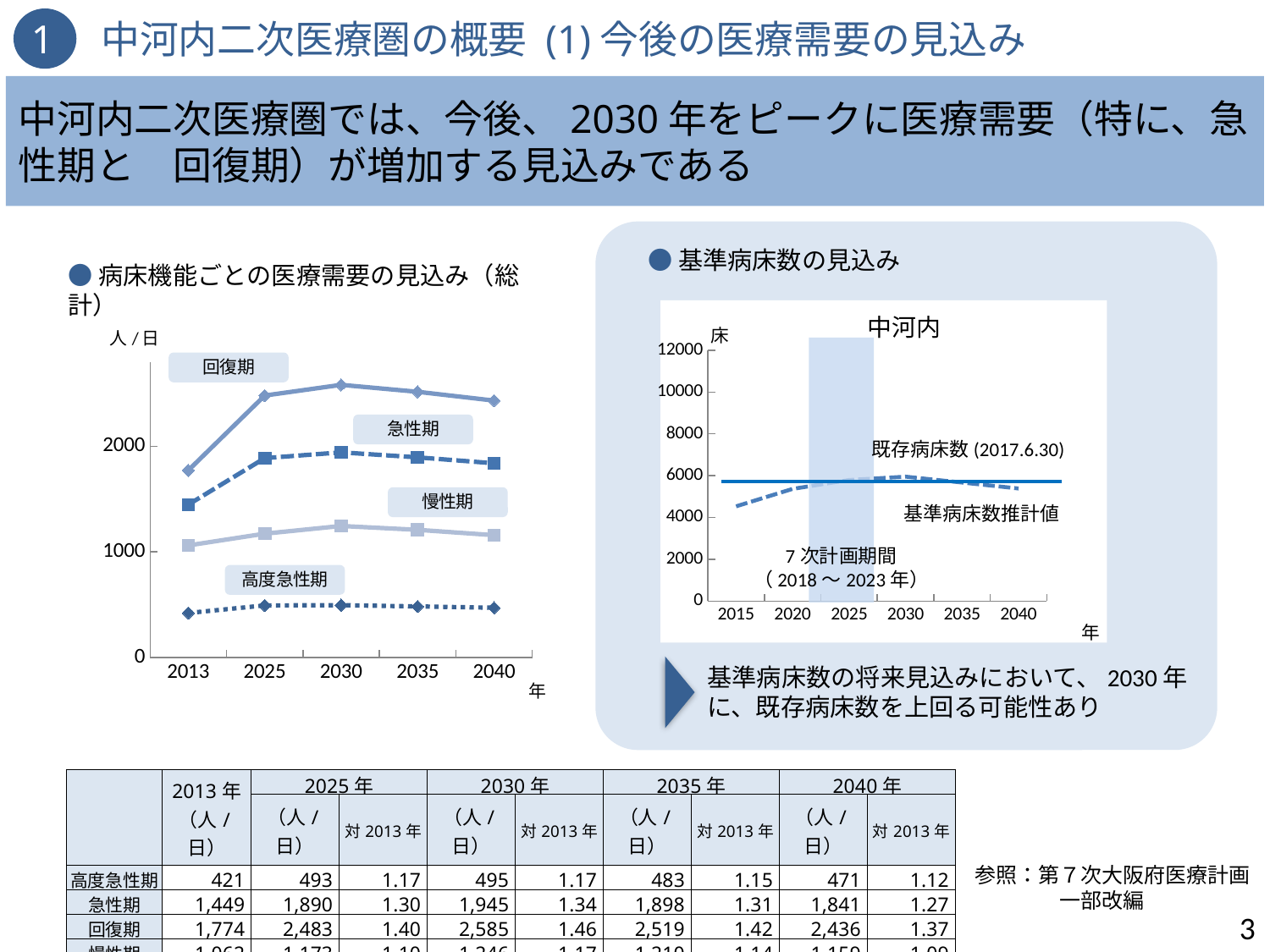
In the left chart 病床機能ごとの医療需要の見込み（総計）, how many series are labelled? 4 In the left chart 病床機能ごとの医療需要の見込み（総計）, which is larger in 2013: 急性期 or 慢性期? 急性期 In the right chart 基準病床数の見込み, is the 既存病床数 line greater or less than 6000 床? less In the left chart 病床機能ごとの医療需要の見込み（総計）, is the value for 回復期 in 2030 greater or less than 2000? greater In the left chart 病床機能ごとの医療需要の見込み（総計）, does the 回復期 line rise or fall from 2013 to 2030? rise In the left chart 病床機能ごとの医療需要の見込み（総計）, which series has the lowest values across all years? 高度急性期 What kind of chart is the left chart titled 病床機能ごとの医療需要の見込み（総計）? line chart In the left chart 病床機能ごとの医療需要の見込み（総計）, which series has the highest values across all years? 回復期 In the left chart 病床機能ごとの医療需要の見込み（総計）, is the value for 高度急性期 in 2013 greater or less than 1000? less In the right chart 基準病床数の見込み, what period is highlighted by the shaded band? 7次計画期間（2018～2023年） In the left chart 病床機能ごとの医療需要の見込み（総計）, how many years are plotted on the x axis? 5